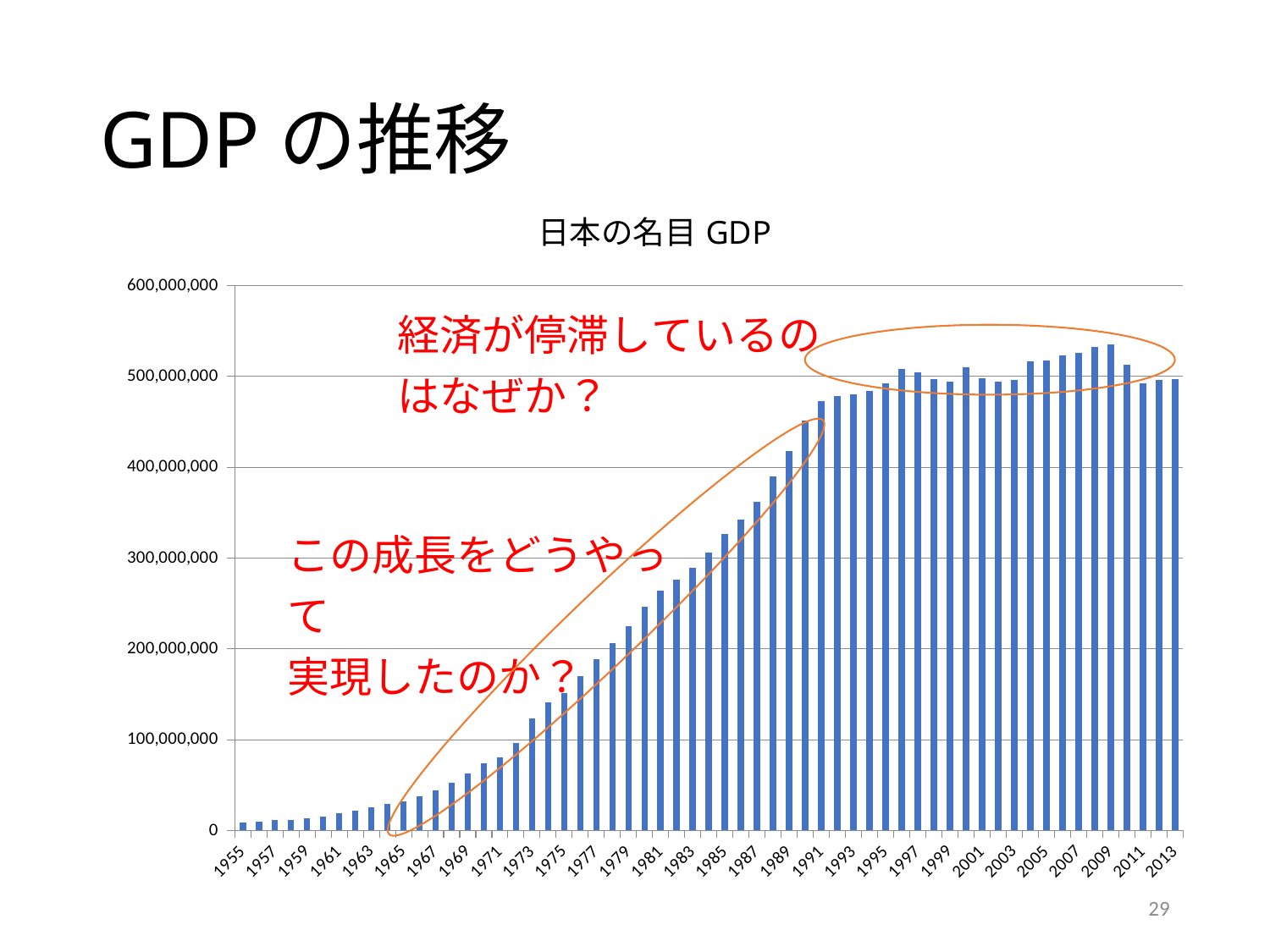
Is the value for 1965 greater or less than 100,000,000? less Which is larger, the value for 1985 or the value for 2001? 2001 Is the value for 1985 greater or less than 300,000,000? greater What is the title of the chart? 日本の名目 GDP Which year has the lowest nominal GDP in the chart? 1955 What is the first year shown on the x axis? 1955 Which is larger, the value for 1975 or the value for 1965? 1975 Is the value for 1981 greater or less than 200,000,000? greater What kind of chart is shown on the slide? Bar chart Do the values rise or fall from 1955 to 1991? Rise